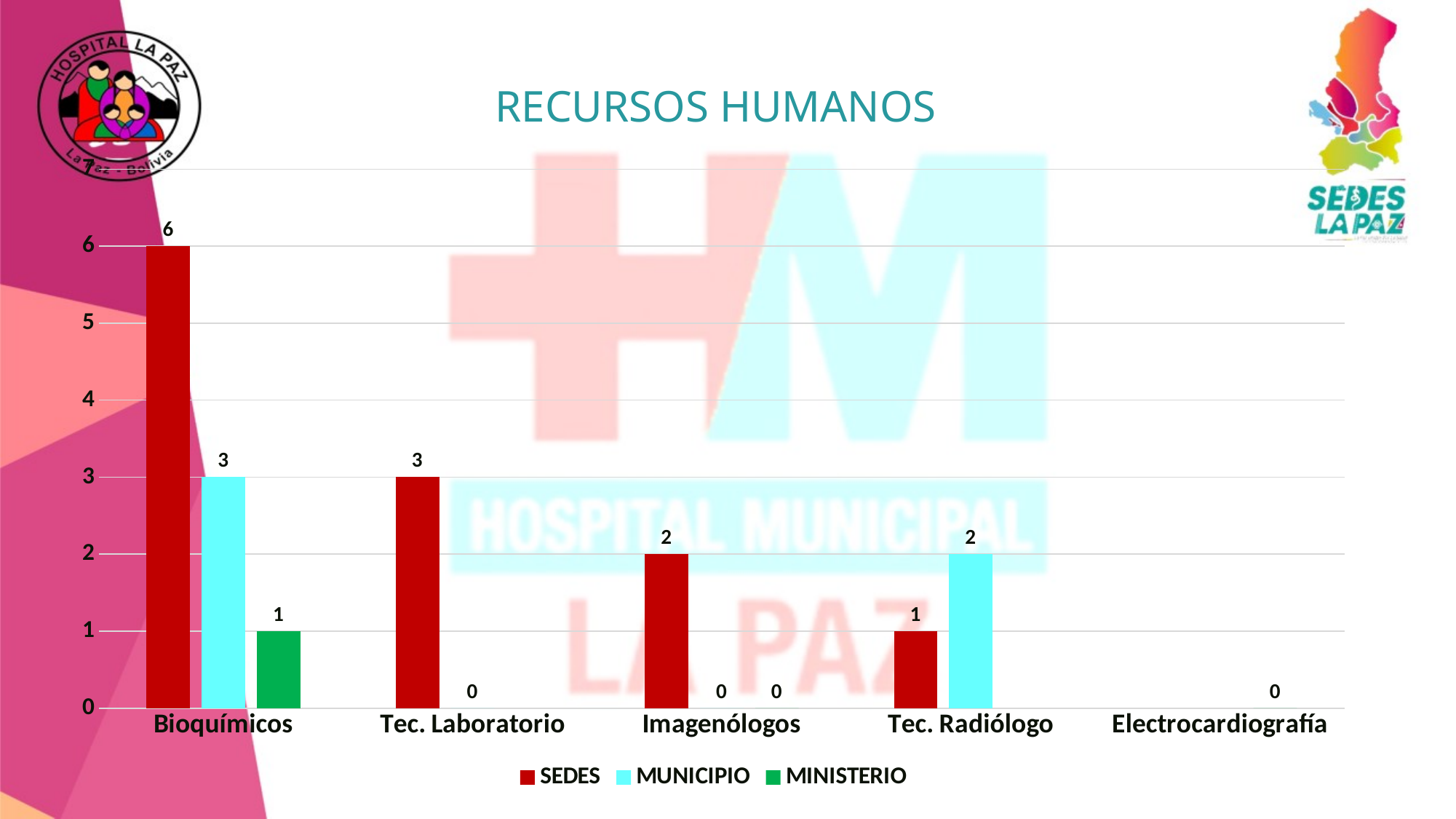
How many series does the legend list? 3 What is the SEDES value for Bioquímicos? 6 What kind of chart is shown on the slide? bar chart What is the SEDES value for Imagenólogos? 2 What is the MINISTERIO value for Bioquímicos? 1 How many categories are shown on the x axis? 5 What is the MUNICIPIO value for Tec. Radiólogo? 2 What is the SEDES value for Tec. Laboratorio? 3 What is the difference between the SEDES and MUNICIPIO values for Bioquímicos? 3 For Tec. Radiólogo, which series has the larger value, SEDES or MUNICIPIO? MUNICIPIO Which category has the highest SEDES value? Bioquímicos What is the title of the chart? RECURSOS HUMANOS